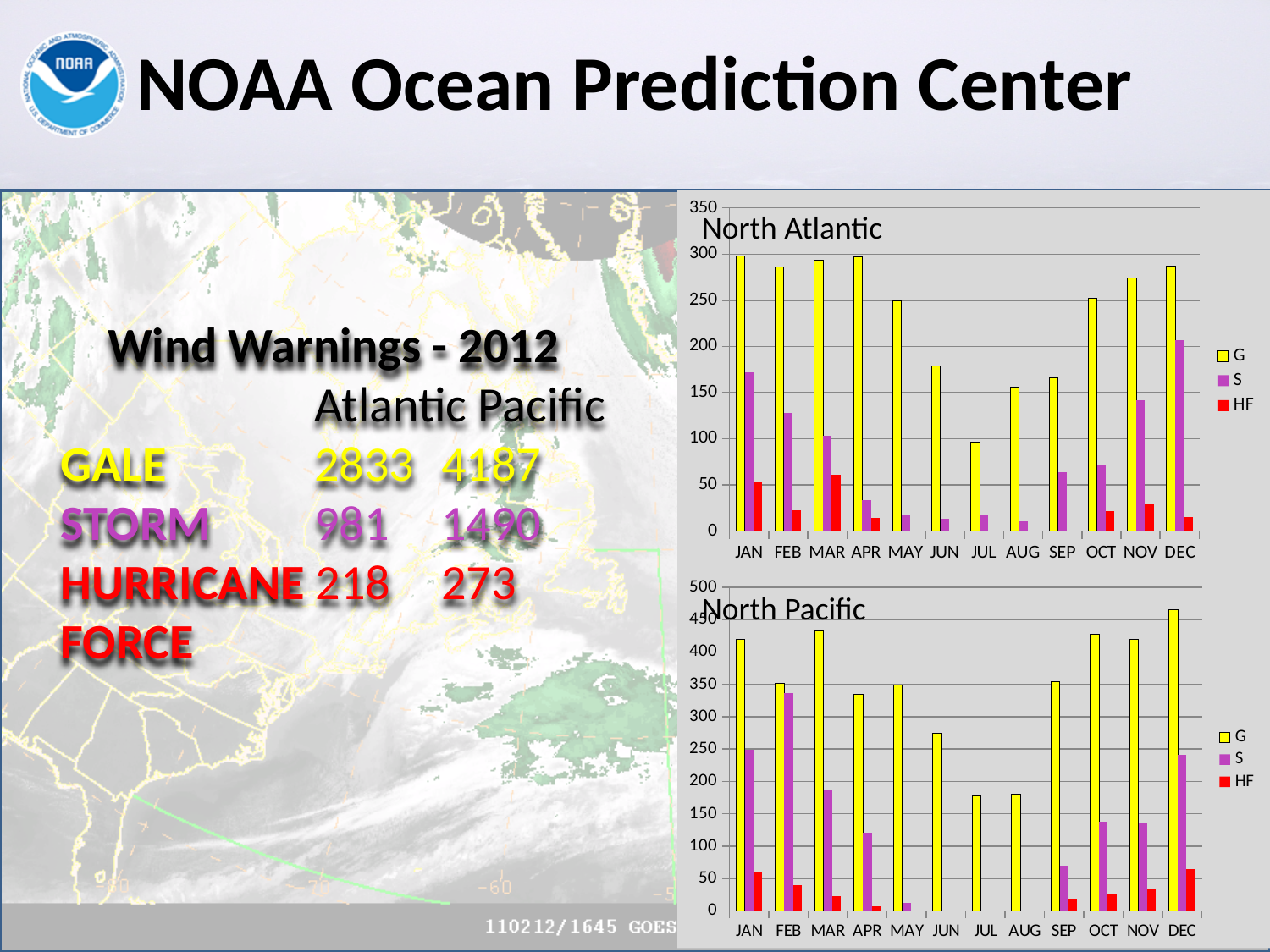
What colour are the HF bars in the North Pacific chart? red In the North Pacific chart, is the G value for DEC greater or less than 450? greater In the North Atlantic chart, which month has the lowest G value? JUL What kind of chart is the North Atlantic chart? bar chart How many months are shown on the x axis of the North Atlantic chart? 12 In the North Atlantic chart, do the G values rise or fall from APR to JUL? fall In the North Atlantic chart, which is larger, the G value for MAY or the G value for JUN? MAY In the North Pacific chart, is the S value for FEB greater or less than 300? greater How many series does the legend of the North Pacific chart list? 3 In the North Pacific chart, which month has the highest G value? DEC In the North Pacific chart, which month has the highest S value? FEB